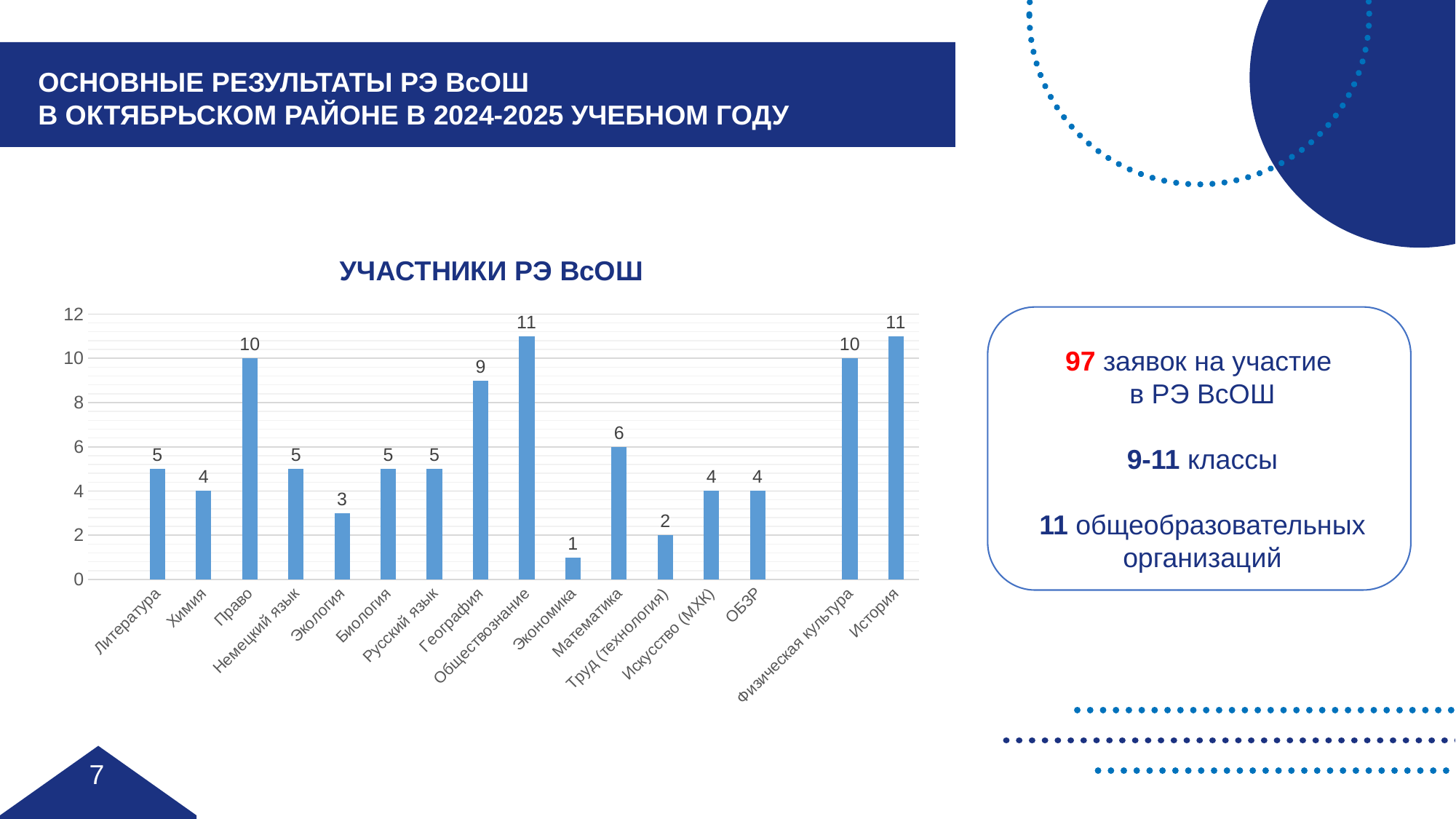
What is the value for История? 11 What is the difference between the values for Обществознание and География? 2 Which category has the lowest value? Экономика What is the value for Математика? 6 What is the value for Труд (технология)? 2 Which is larger, the value for Химия or the value for Биология? Биология What is the value for Экология? 3 What type of chart is shown on the slide? bar chart What is the title of the chart? УЧАСТНИКИ РЭ ВсОШ What is the difference between the values for Физическая культура and Литература? 5 How many categories are shown on the x axis of the chart? 16 What is the value for Право? 10